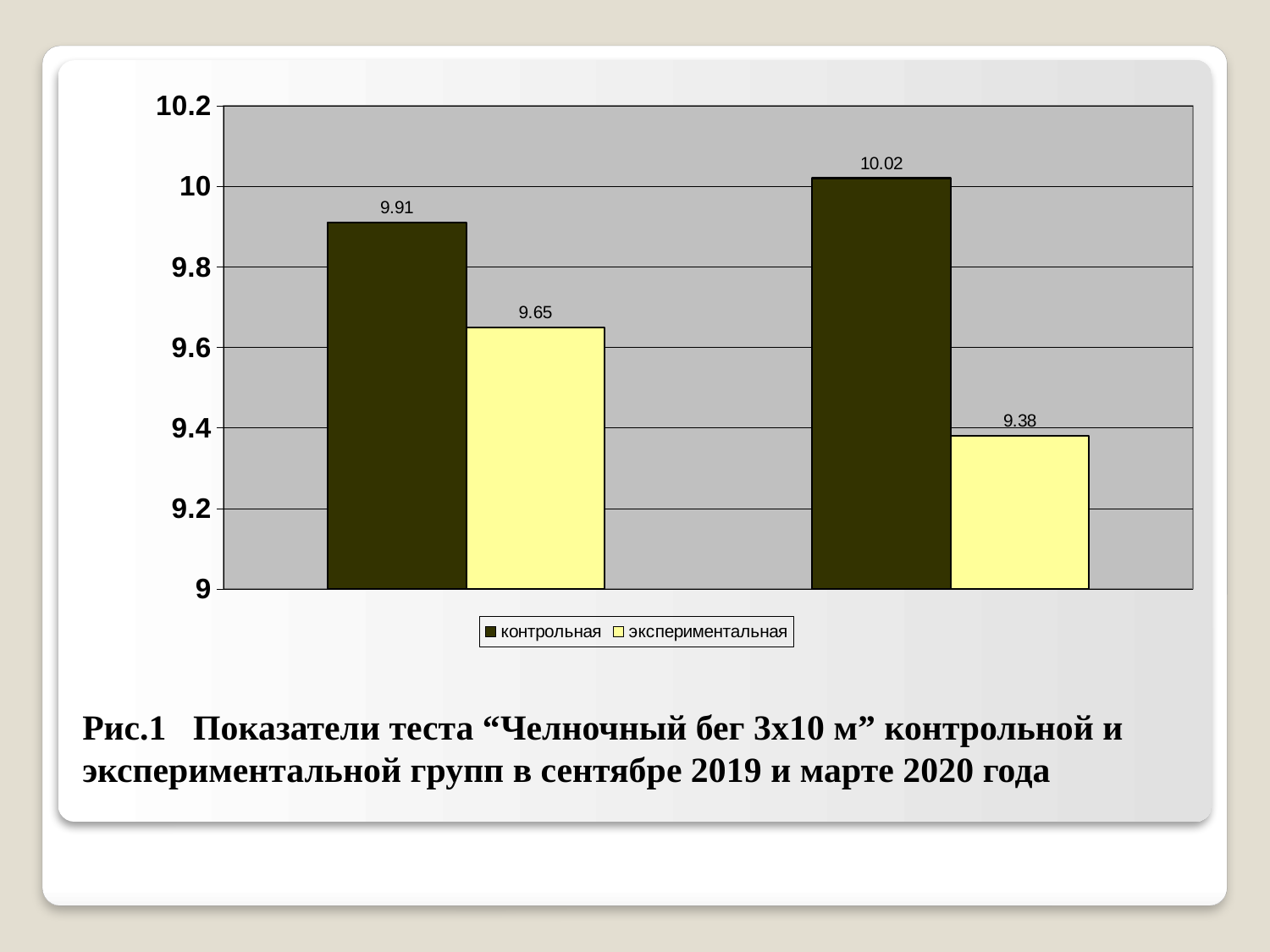
What is the value of the экспериментальная bar in the right group of bars? 9.38 Which bar has the highest value on the chart? контрольная in the right group (10.02) In the right group of bars, what is the difference between the контрольная and экспериментальная values? 0.64 Is the контрольная value larger in the left group or the right group of bars? right group What is the value of the экспериментальная bar in the left group of bars? 9.65 What kind of chart is shown on the slide? bar chart In the left group of bars, what is the difference between the контрольная and экспериментальная values? 0.26 What is the value of the контрольная bar in the left group of bars? 9.91 Which bar has the lowest value on the chart? экспериментальная in the right group (9.38) How many bars are plotted on the chart in total? 4 How many series does the legend list? 2 What is the value of the контрольная bar in the right group of bars? 10.02